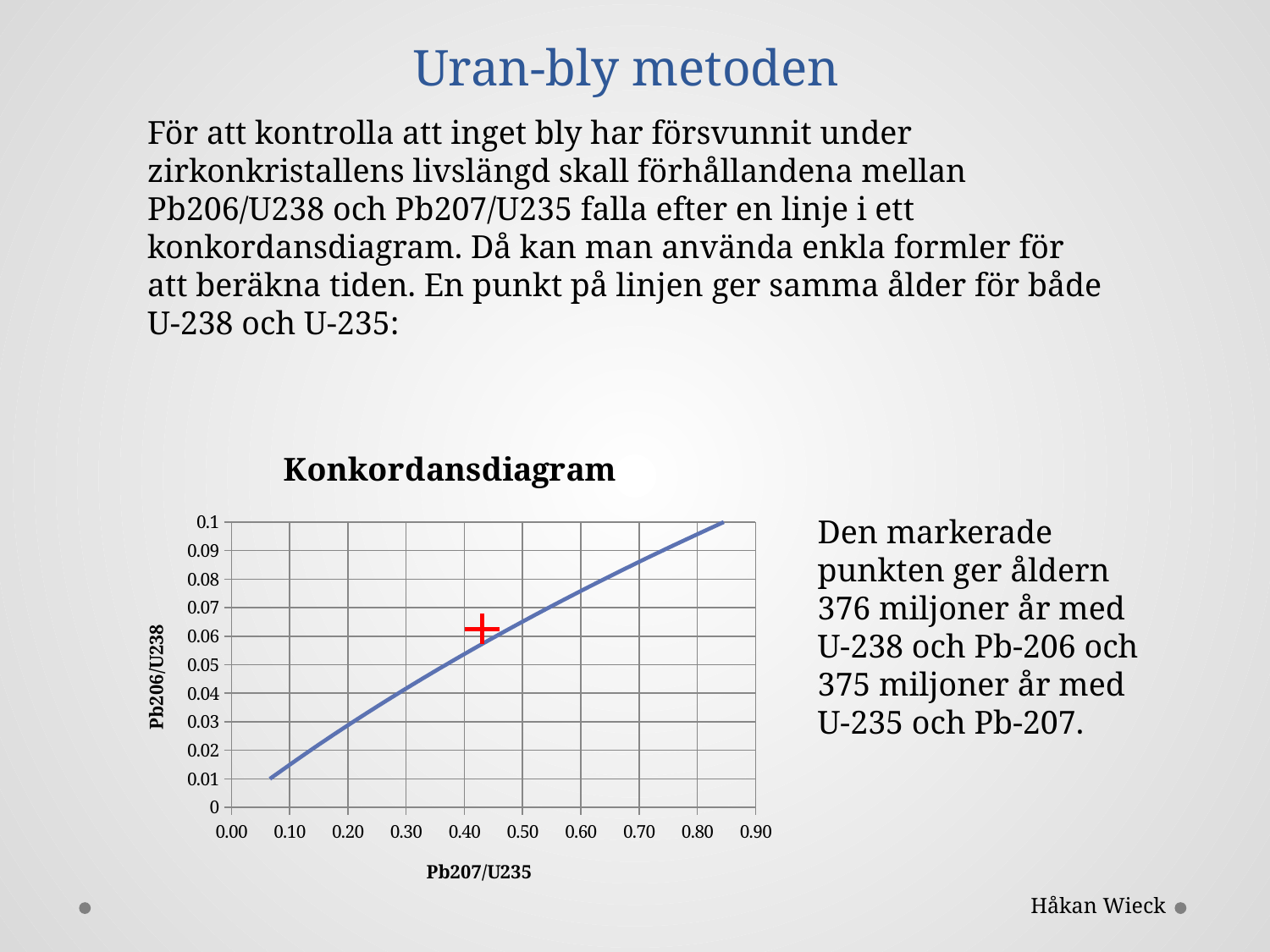
In the Konkordansdiagram, is the Pb206/U238 value of the curve at Pb207/U235 = 0.60 greater or less than 0.07? greater What kind of chart is the Konkordansdiagram? line chart Does the curve in the Konkordansdiagram rise or fall as Pb207/U235 increases? rise In the Konkordansdiagram, is the Pb206/U238 value of the red marked point greater or less than 0.07? less What is the title of the chart on the slide? Konkordansdiagram In the Konkordansdiagram, is the Pb206/U238 value of the curve at Pb207/U235 = 0.10 greater or less than 0.03? less What is the label of the vertical axis of the chart? Pb206/U238 What is the highest tick value shown on the vertical axis of the Konkordansdiagram? 0.1 What is the highest tick value shown on the horizontal axis of the Konkordansdiagram? 0.90